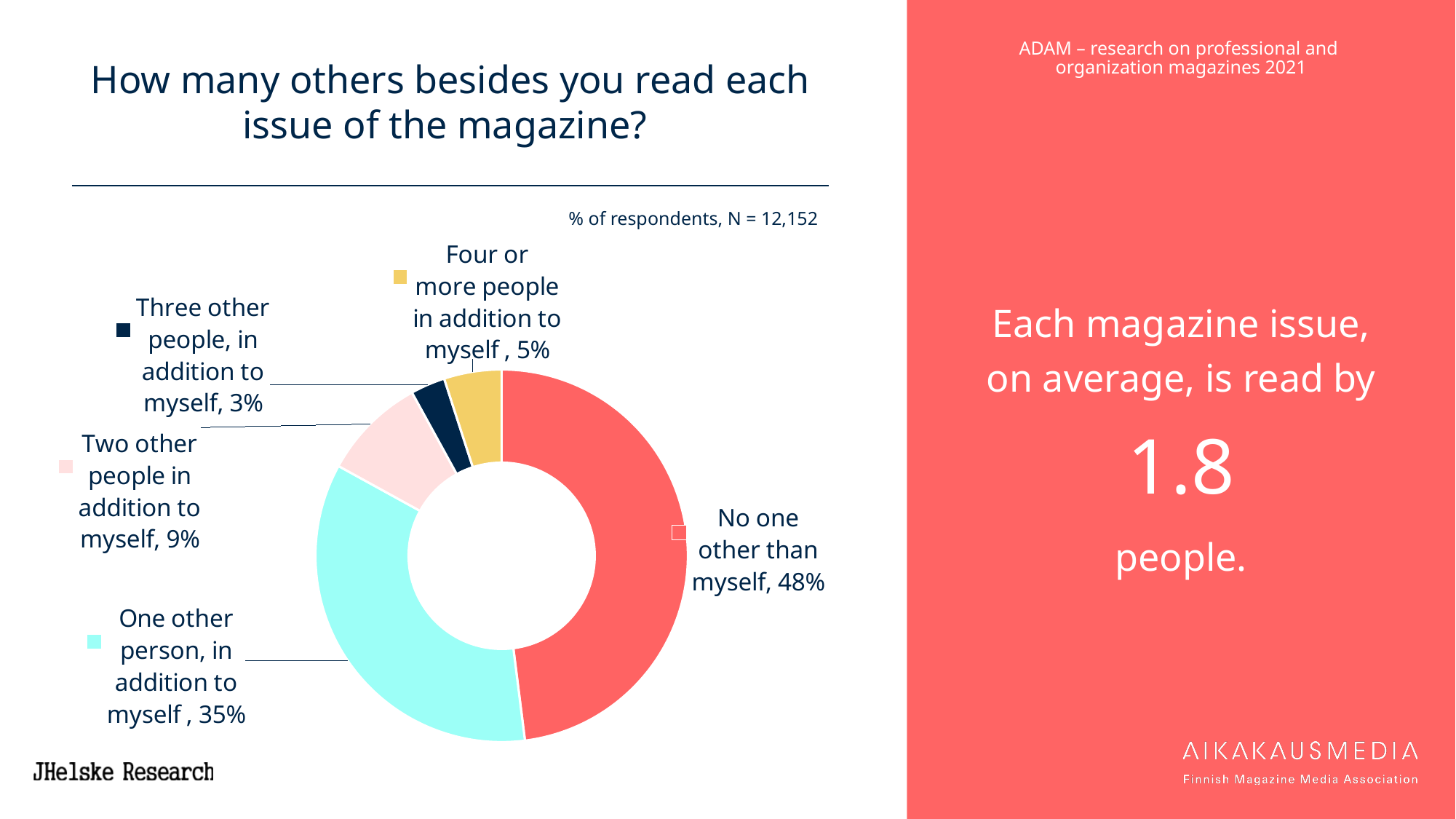
What percentage of respondents said three other people in addition to themselves read each issue? 3% What percentage of respondents said no one other than themselves reads each issue of the magazine? 48% What is the difference in percentage points between 'No one other than myself' and 'One other person, in addition to myself'? 13 percentage points Which category has the smallest share of respondents? Three other people, in addition to myself What is the number of respondents (N) stated on the slide? 12,152 What percentage of respondents said four or more people in addition to themselves read each issue? 5% What percentage of respondents said one other person in addition to themselves reads each issue? 35% Which is larger: the share for 'Two other people in addition to myself' or 'Four or more people in addition to myself'? Two other people in addition to myself What type of chart is shown on the slide? Doughnut (pie) chart What percentage of respondents said two other people in addition to themselves read each issue? 9% How many categories are shown in the chart? 5 Which category has the largest share of respondents? No one other than myself